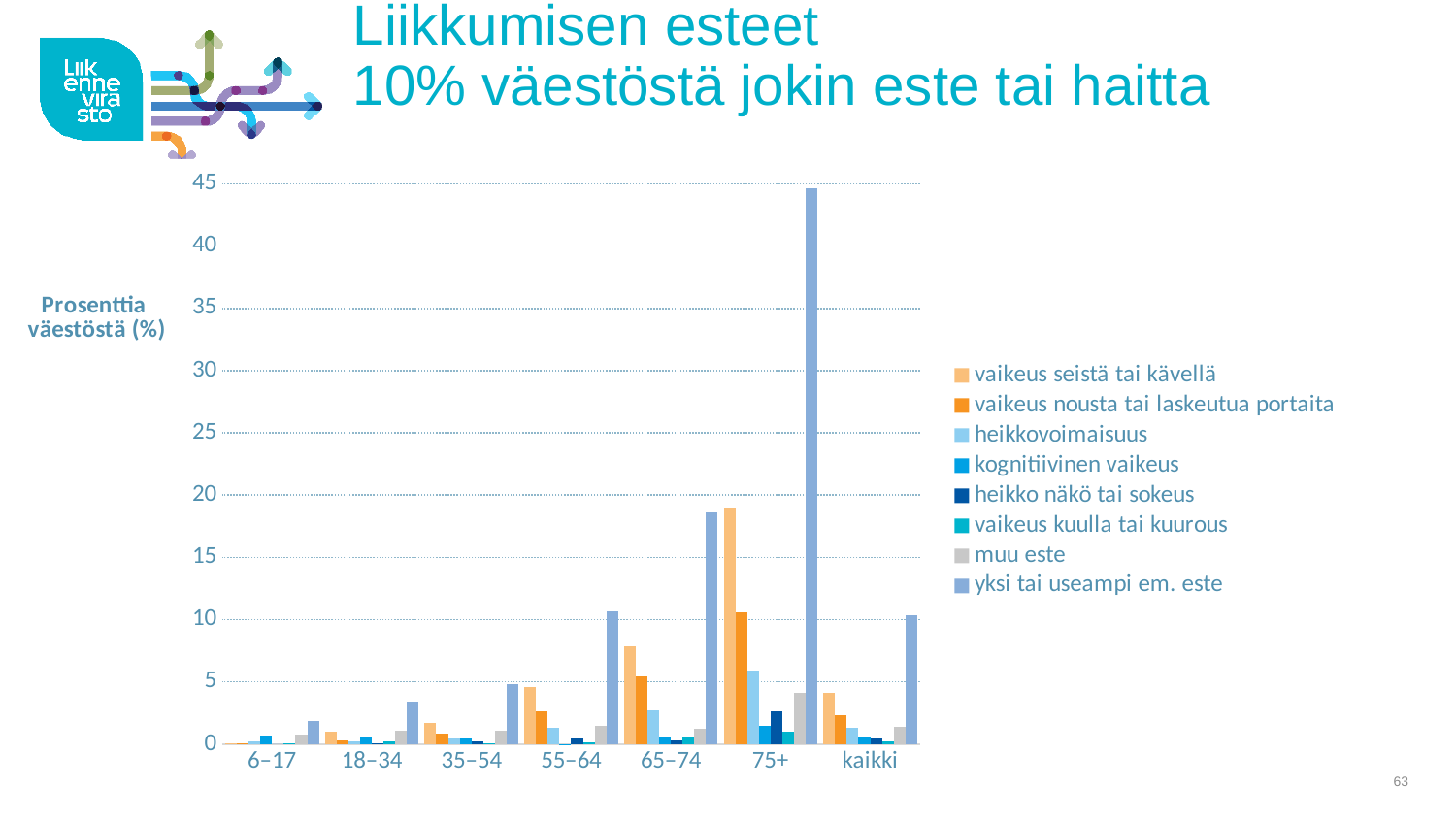
Does the value for 'yksi tai useampi em. este' rise or fall across the age groups from 6–17 to 75+? rise Is the value for 'vaikeus seistä tai kävellä' in the 75+ group greater or less than 15? greater How many series does the legend list? 8 Is the value for 'vaikeus nousta tai laskeutua portaita' in the 75+ group greater or less than 5? greater In the 75+ group, which is larger: 'vaikeus seistä tai kävellä' or 'vaikeus nousta tai laskeutua portaita'? vaikeus seistä tai kävellä Is the value for 'yksi tai useampi em. este' in the 65–74 group greater or less than 15? greater How many categories are shown along the x axis? 7 What is the label of the y axis? Prosenttia väestöstä (%) Which age group has the highest value for 'yksi tai useampi em. este'? 75+ What kind of chart is shown on the slide? bar chart